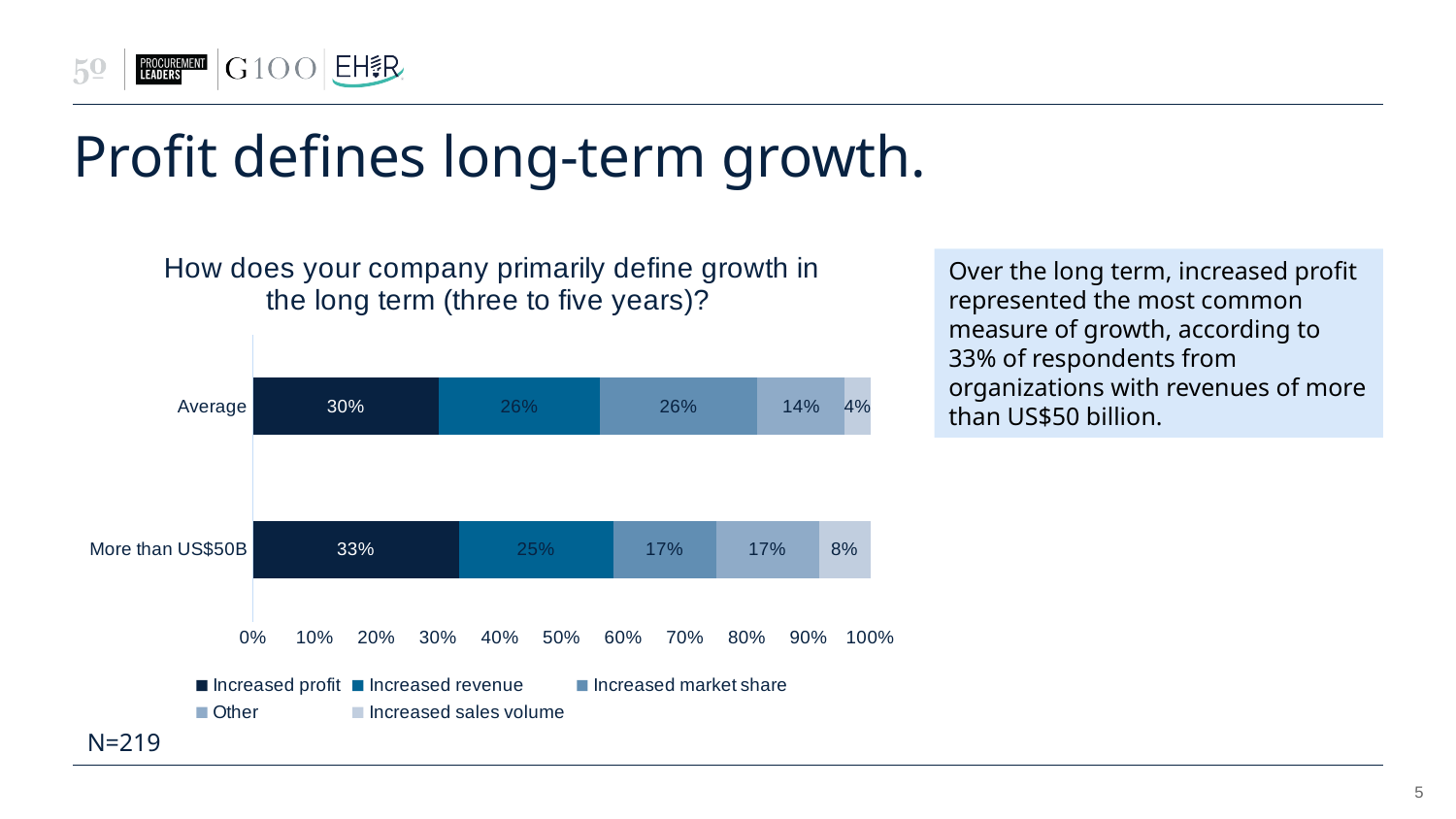
What is the title of the chart? How does your company primarily define growth in the long term (three to five years)? Which series has the lowest value in the More than US$50B bar? Increased sales volume What is the value for Increased profit in the More than US$50B bar? 33% What type of chart is shown on the slide? Stacked bar chart How many categories (bars) are shown on the chart? 2 What is the value for Increased sales volume in the Average bar? 4% What is the value for Increased profit in the Average bar? 30% What is the value for Other in the Average bar? 14% Which is larger: Increased market share for Average or Increased market share for More than US$50B? Average How many series does the legend list? 5 What is the value for Increased market share in the More than US$50B bar? 17% What is the difference between the Increased profit values for More than US$50B and Average? 3%